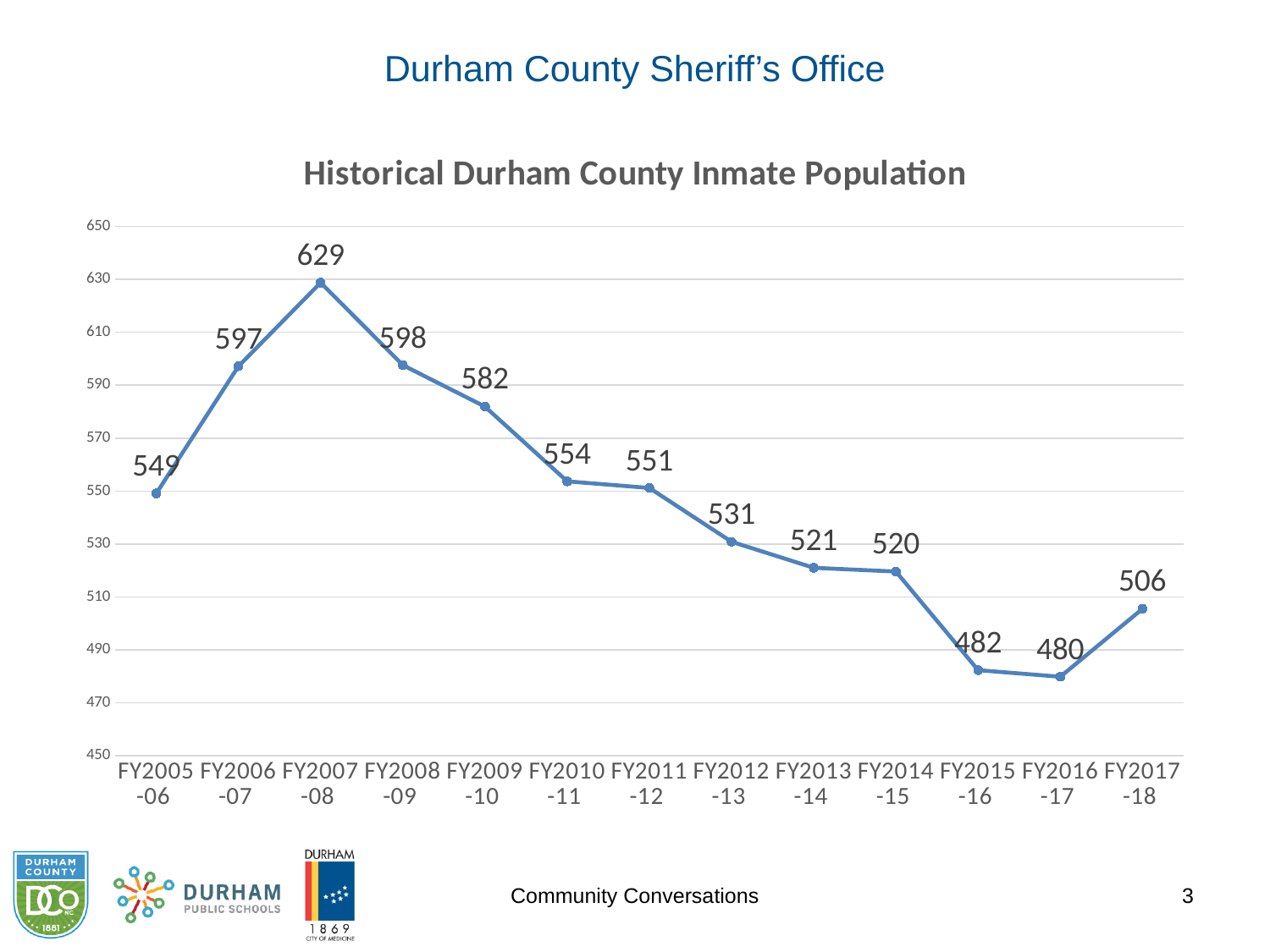
What is the difference between the inmate population in FY2007-08 and FY2016-17? 149 Which is larger, the inmate population in FY2008-09 or FY2009-10? FY2008-09 What is the inmate population for FY2007-08? 629 What is the title of the chart? Historical Durham County Inmate Population What is the difference between the inmate population in FY2005-06 and FY2006-07? 48 How many fiscal years are plotted on the chart? 13 Which fiscal year has the highest inmate population? FY2007-08 What kind of chart is shown on the slide? line chart What is the inmate population for FY2017-18? 506 Which fiscal year has the lowest inmate population? FY2016-17 What is the inmate population for FY2012-13? 531 Is the inmate population for FY2015-16 greater or less than 490? less